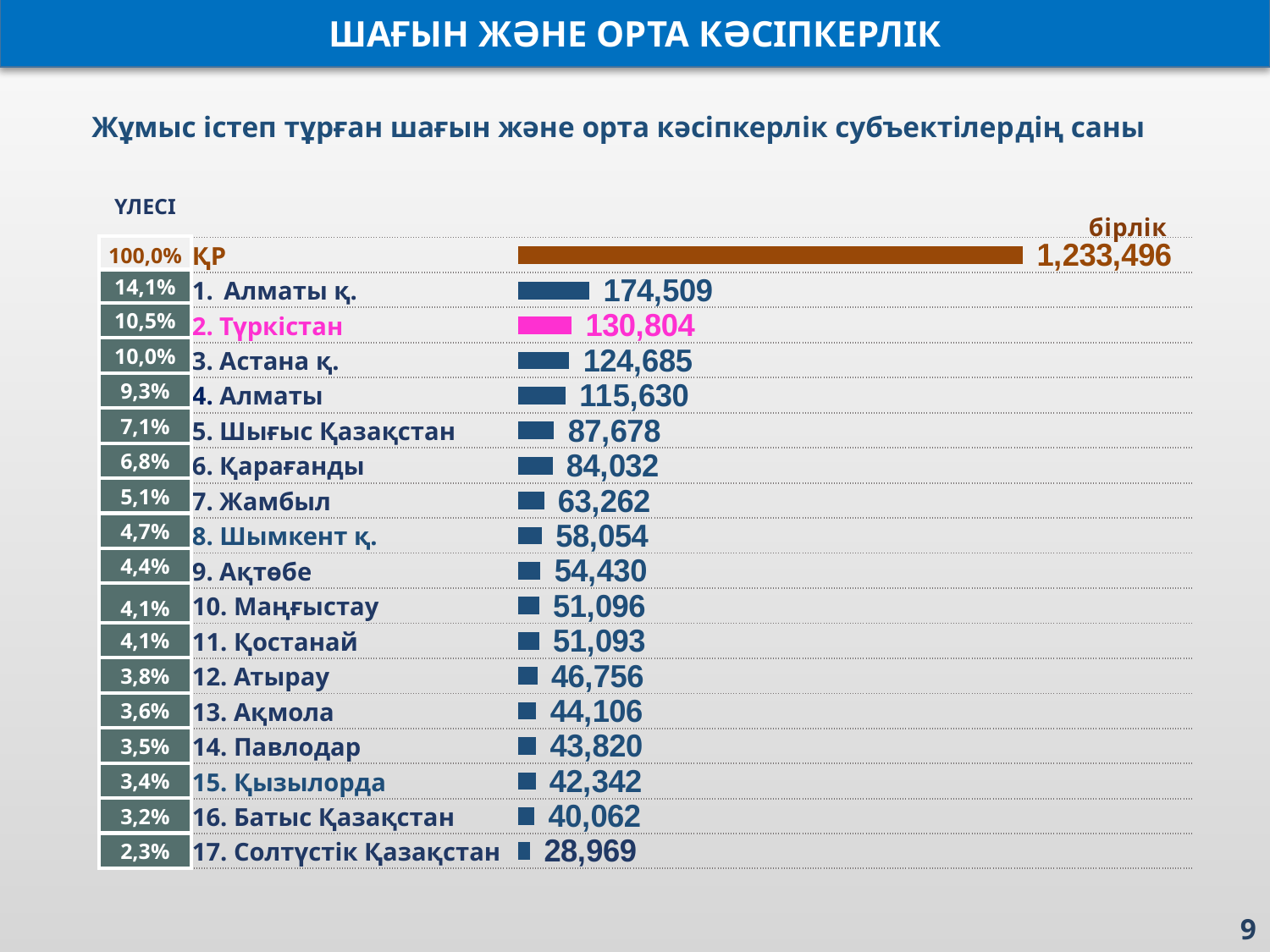
Which is larger, the value for Астана қ. or the value for Алматы? Астана қ. Which region has the lowest value? Солтүстік Қазақстан Which region's bar and label are highlighted in pink? Түркістан Among the numbered regions, which has the highest value? Алматы қ. What is the value shown for Түркістан? 130,804 What share (үлесі) is shown for Қарағанды? 6,8% What is the difference between the values for Алматы қ. and Түркістан? 43,705 What is the value shown for Алматы қ.? 174,509 What is the value shown for ҚР (the total bar)? 1,233,496 What kind of chart is shown on the slide? Bar chart What is the value shown for Солтүстік Қазақстан? 28,969 How many numbered regions are listed in the chart? 17